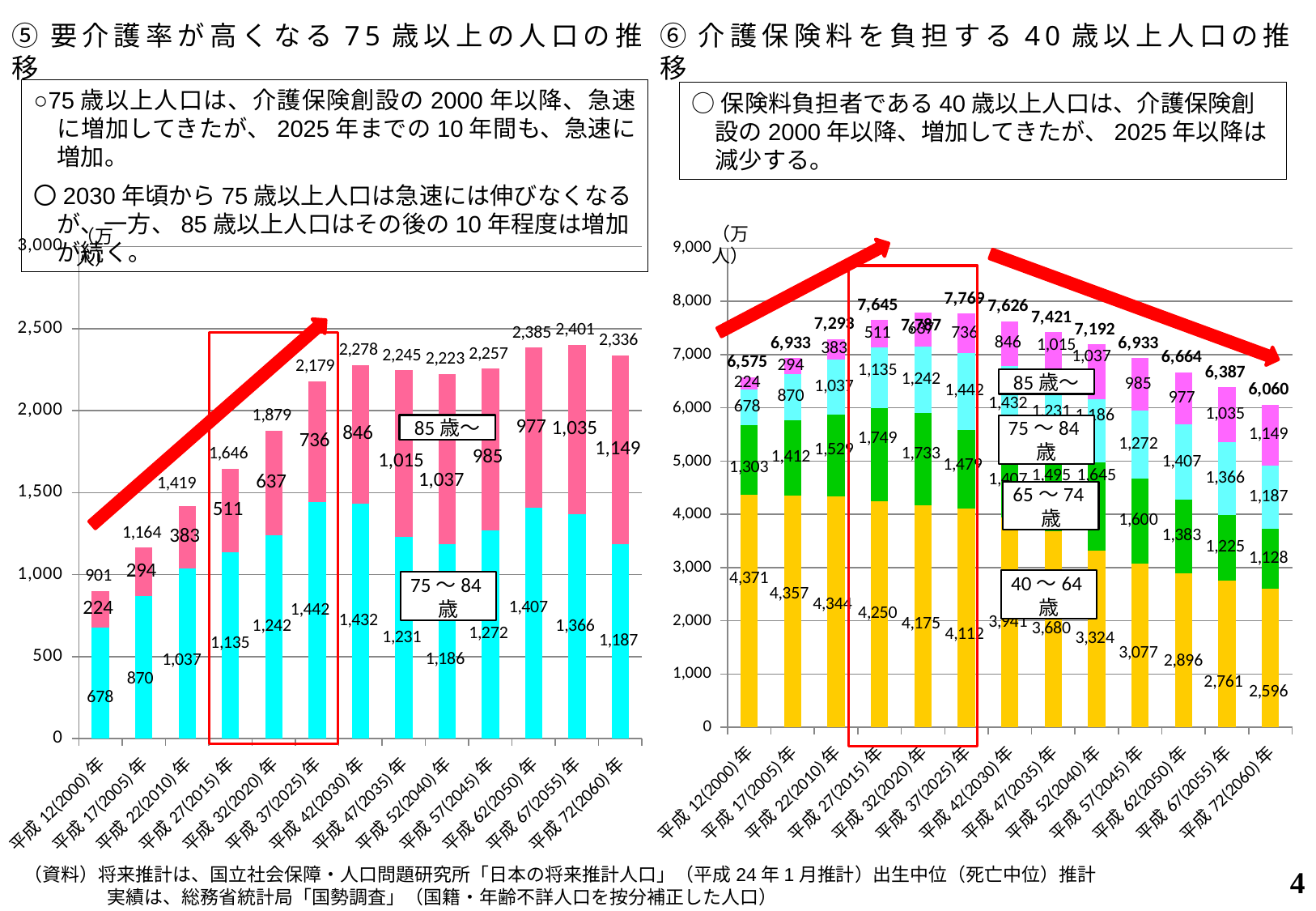
In the left chart (⑤), which year has the highest total 75歳以上 population? 平成67(2055)年 In the right chart (⑥ 介護保険料を負担する40歳以上人口の推移), what is the total shown for 平成32(2020)年? 7,787 How many years (bars) are plotted in the left chart (⑤)? 13 What kind of chart is the left chart (⑤ 要介護率が高くなる75歳以上の人口の推移)? Stacked bar chart In the left chart (⑤), what is the total 75歳以上 population shown for 平成37(2025)年? 2,179 In the right chart (⑥), is the 40～64歳 value larger for 平成12(2000)年 or 平成72(2060)年? 平成12(2000)年 In the right chart (⑥), which year has the highest total 40歳以上 population? 平成32(2020)年 In the left chart (⑤), what is the 85歳～ value for 平成72(2060)年? 1,149 In the left chart (⑤), what is the difference between the 75～84歳 value for 平成37(2025)年 and for 平成12(2000)年? 764 In the right chart (⑥), do the total values rise or fall from 平成37(2025)年 to 平成72(2060)年? Fall In the right chart (⑥), which year has the lowest 40～64歳 value? 平成72(2060)年 In the right chart (⑥), what is the 40～64歳 value for 平成12(2000)年? 4,371